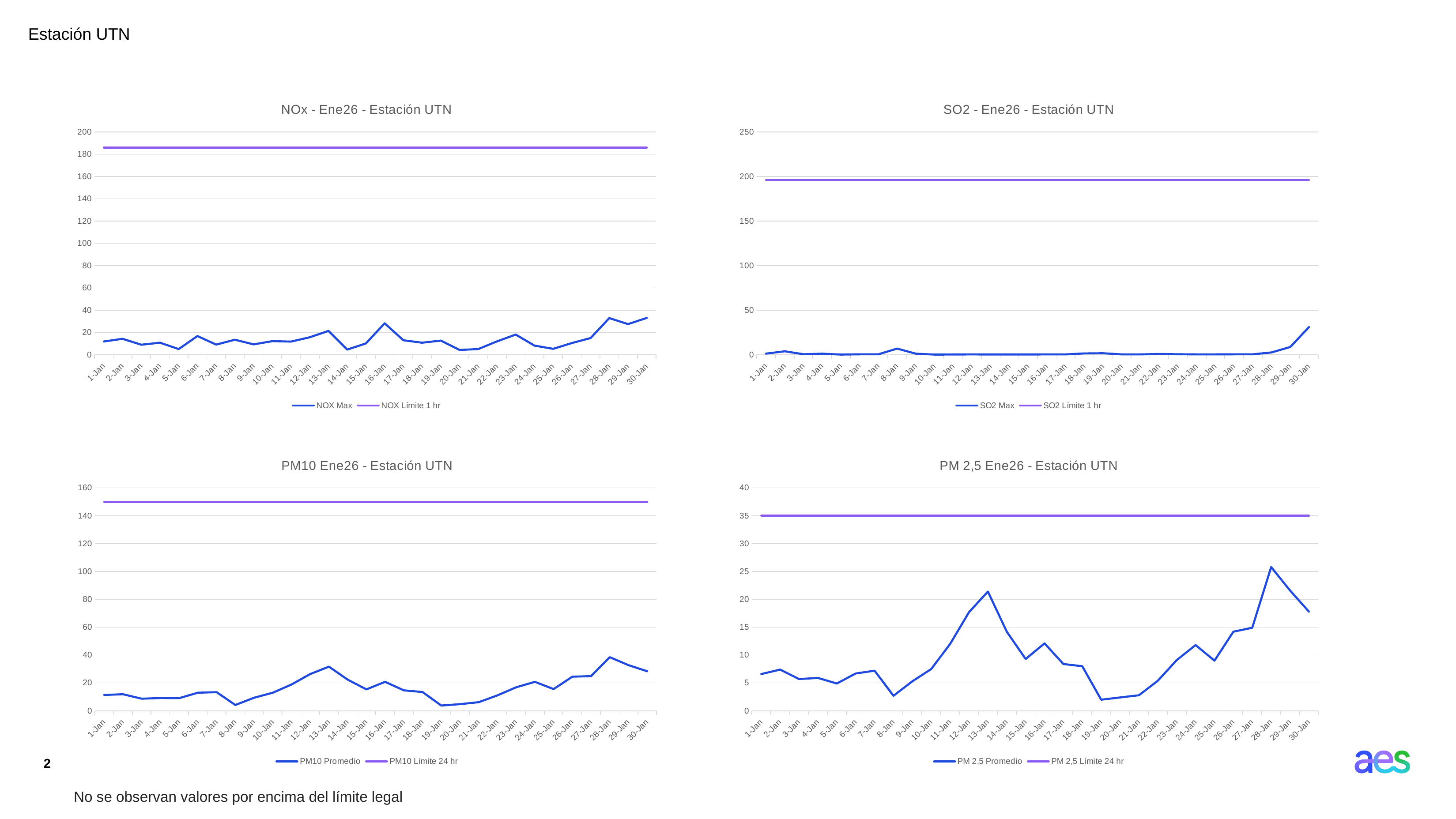
In the 'NOx - Ene26 - Estación UTN' chart, is the NOX Max value for 16-Jan greater or less than 20? greater In the 'PM10 Ene26 - Estación UTN' chart, on which date is PM10 Promedio highest? 28-Jan In the 'PM 2,5 Ene26 - Estación UTN' chart, which is larger, the PM 2,5 Promedio value for 13-Jan or for 28-Jan? 28-Jan What kind of chart is the 'NOx - Ene26 - Estación UTN' chart? line chart How many dates are plotted along the x axis of the 'PM10 Ene26 - Estación UTN' chart? 30 How many series does the legend of the 'SO2 - Ene26 - Estación UTN' chart list? 2 In the 'PM 2,5 Ene26 - Estación UTN' chart, at what value does the PM 2,5 Límite 24 hr line sit? 35 In the 'SO2 - Ene26 - Estación UTN' chart, on which date is SO2 Max highest? 30-Jan In the 'PM 2,5 Ene26 - Estación UTN' chart, on which date is PM 2,5 Promedio highest? 28-Jan In the 'PM 2,5 Ene26 - Estación UTN' chart, does PM 2,5 Promedio rise or fall from 19-Jan to 28-Jan? rise In the 'PM10 Ene26 - Estación UTN' chart, is the PM10 Promedio value for 13-Jan greater or less than 20? greater